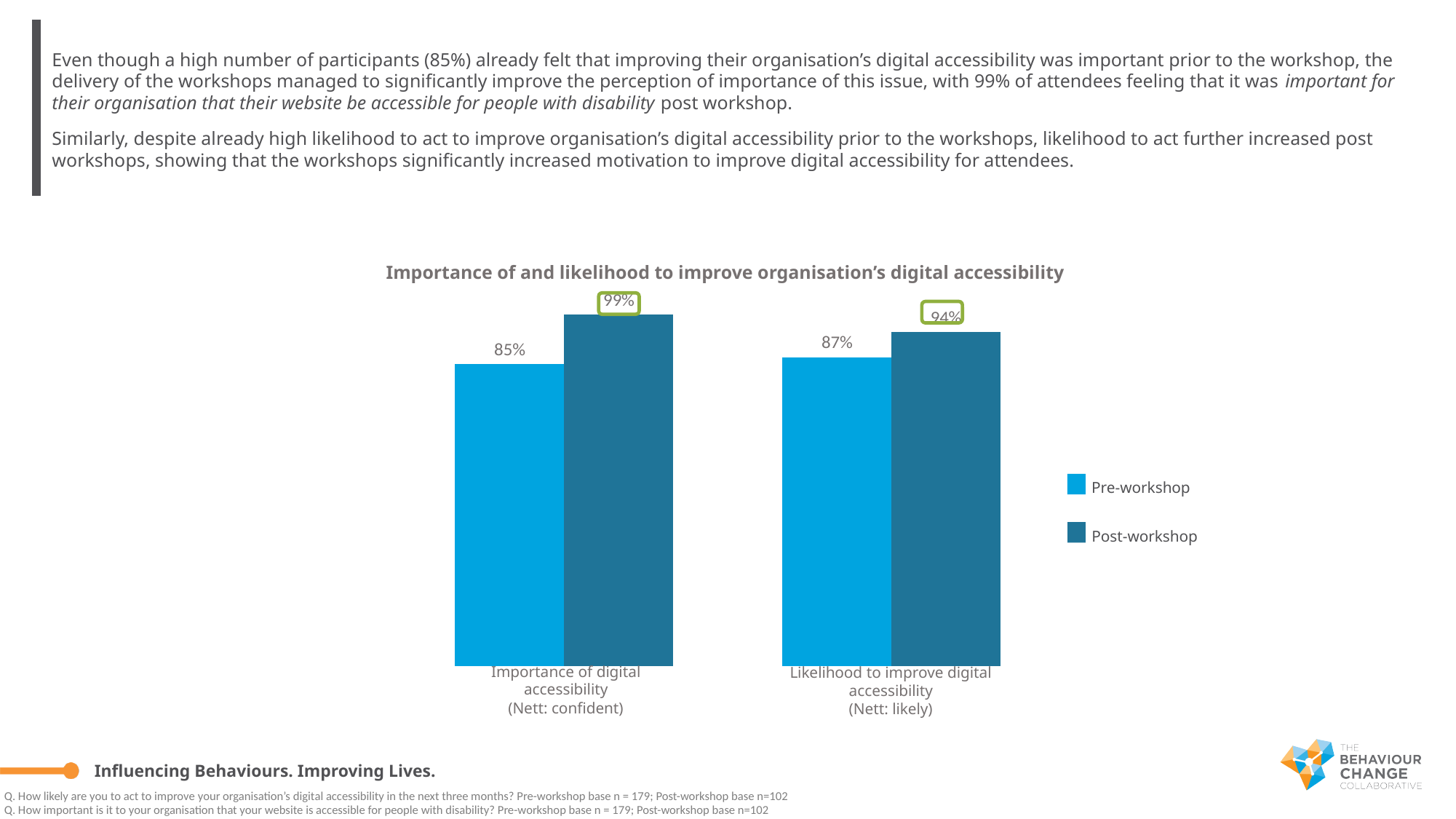
What is the Post-workshop value for Importance of digital accessibility (Nett: confident)? 99% Which bar in the chart has the lowest value? Pre-workshop, Importance of digital accessibility (85%) What is the Post-workshop value for Likelihood to improve digital accessibility (Nett: likely)? 94% What is the Pre-workshop value for Likelihood to improve digital accessibility (Nett: likely)? 87% Which is larger: the Pre-workshop value for Importance of digital accessibility or the Pre-workshop value for Likelihood to improve digital accessibility? Likelihood to improve digital accessibility (87%) How many series does the chart's legend list? 2 What type of chart is shown on the slide? Bar chart What is the Pre-workshop value for Importance of digital accessibility (Nett: confident)? 85% What is the difference between the Post-workshop and Pre-workshop values for Likelihood to improve digital accessibility? 7 percentage points Which bar in the chart has the highest value? Post-workshop, Importance of digital accessibility (99%) What is the difference between the Post-workshop and Pre-workshop values for Importance of digital accessibility? 14 percentage points How many categories are shown on the x axis of the chart? 2